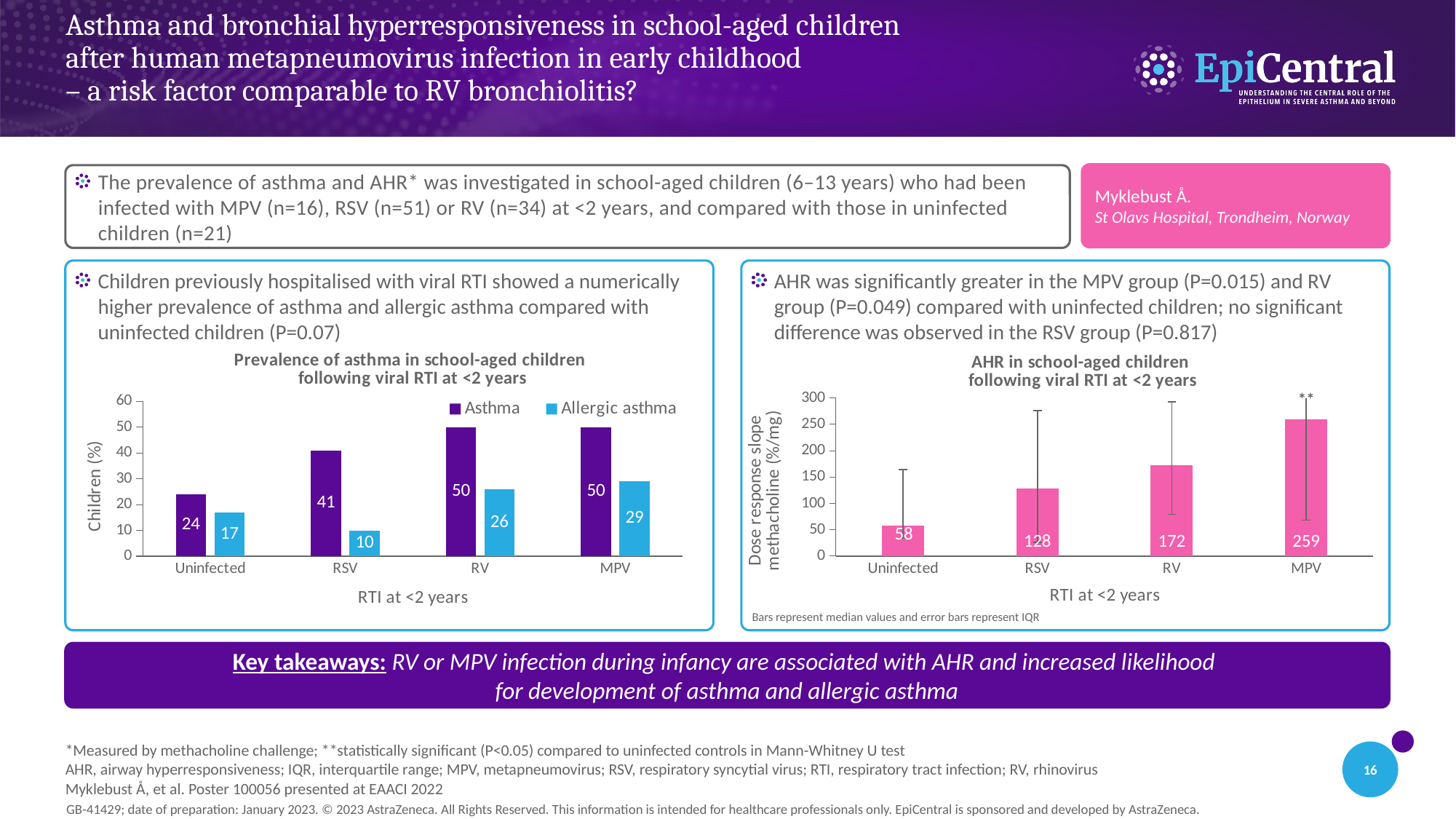
In the 'AHR in school-aged children' chart, which category has the highest value? MPV In the 'AHR in school-aged children' chart, what is the value for RV? 172 In the 'AHR in school-aged children' chart, is the value for RSV larger than the value for RV? No In the 'Prevalence of asthma' chart, which category has the lowest Allergic asthma value? RSV In the 'Prevalence of asthma' chart, what is the label of the y axis? Children (%) What kind of chart is the 'AHR in school-aged children' chart? Bar chart In the 'AHR in school-aged children' chart, what is the difference between the MPV and Uninfected values? 201 In the 'Prevalence of asthma' chart, which category has the highest Allergic asthma value? MPV In the 'Prevalence of asthma' chart, what is the Allergic asthma value for Uninfected children? 17 In the 'Prevalence of asthma' chart, what is the Asthma value for RSV? 41 In the 'Prevalence of asthma' chart, how many series does the legend list? 2 In the 'Prevalence of asthma' chart, what is the difference between the Asthma and Allergic asthma values for RV? 24